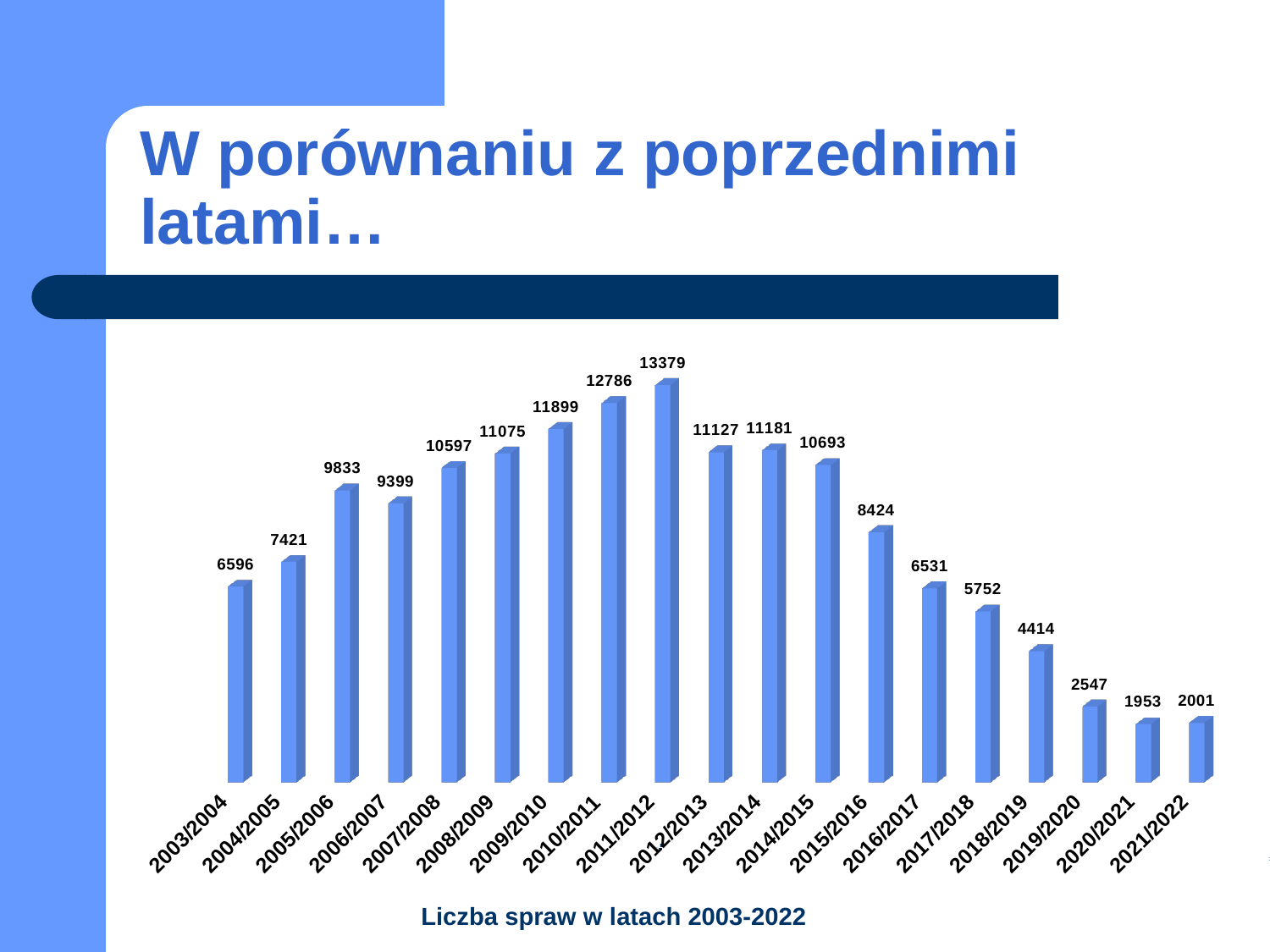
Which is larger, the value for 2005/2006 or the value for 2006/2007? 2005/2006 What kind of chart is shown on the slide? bar chart What is the value for 2021/2022? 2001 What is the value for 2003/2004? 6596 Which year has the highest value? 2011/2012 What is the difference between the values for 2011/2012 and 2021/2022? 11378 Which year has the lowest value? 2020/2021 What is the value for 2011/2012? 13379 Do the values rise or fall from 2011/2012 to 2020/2021? fall What is the caption shown below the chart? Liczba spraw w latach 2003-2022 What is the difference between the values for 2015/2016 and 2016/2017? 1893 How many years are shown on the x axis? 19